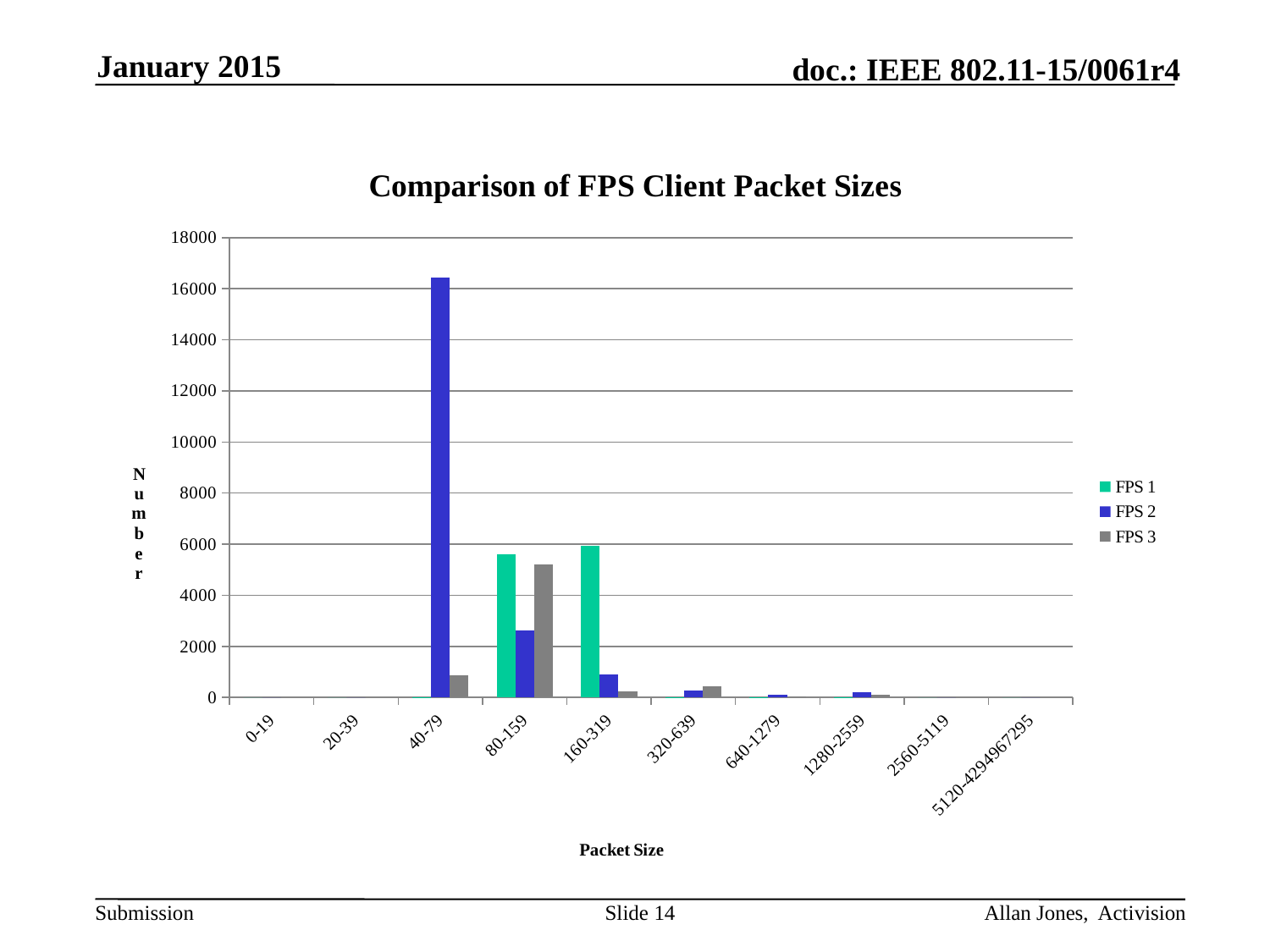
Is the FPS 2 value for the 40-79 packet size greater or less than 16000? greater For the 80-159 packet size, which series has the larger value, FPS 2 or FPS 3? FPS 3 For which packet size category is the FPS 3 value highest? 80-159 For the 160-319 packet size, which series has the larger value, FPS 1 or FPS 2? FPS 1 For which packet size category is the FPS 2 value highest? 40-79 How many packet size categories are shown on the x axis? 10 Is the FPS 2 value for the 80-159 packet size greater or less than 4000? less How many series does the legend list? 3 What is the title of the chart? Comparison of FPS Client Packet Sizes Is the FPS 3 value for the 40-79 packet size greater or less than 2000? less What kind of chart is shown on the slide? bar chart